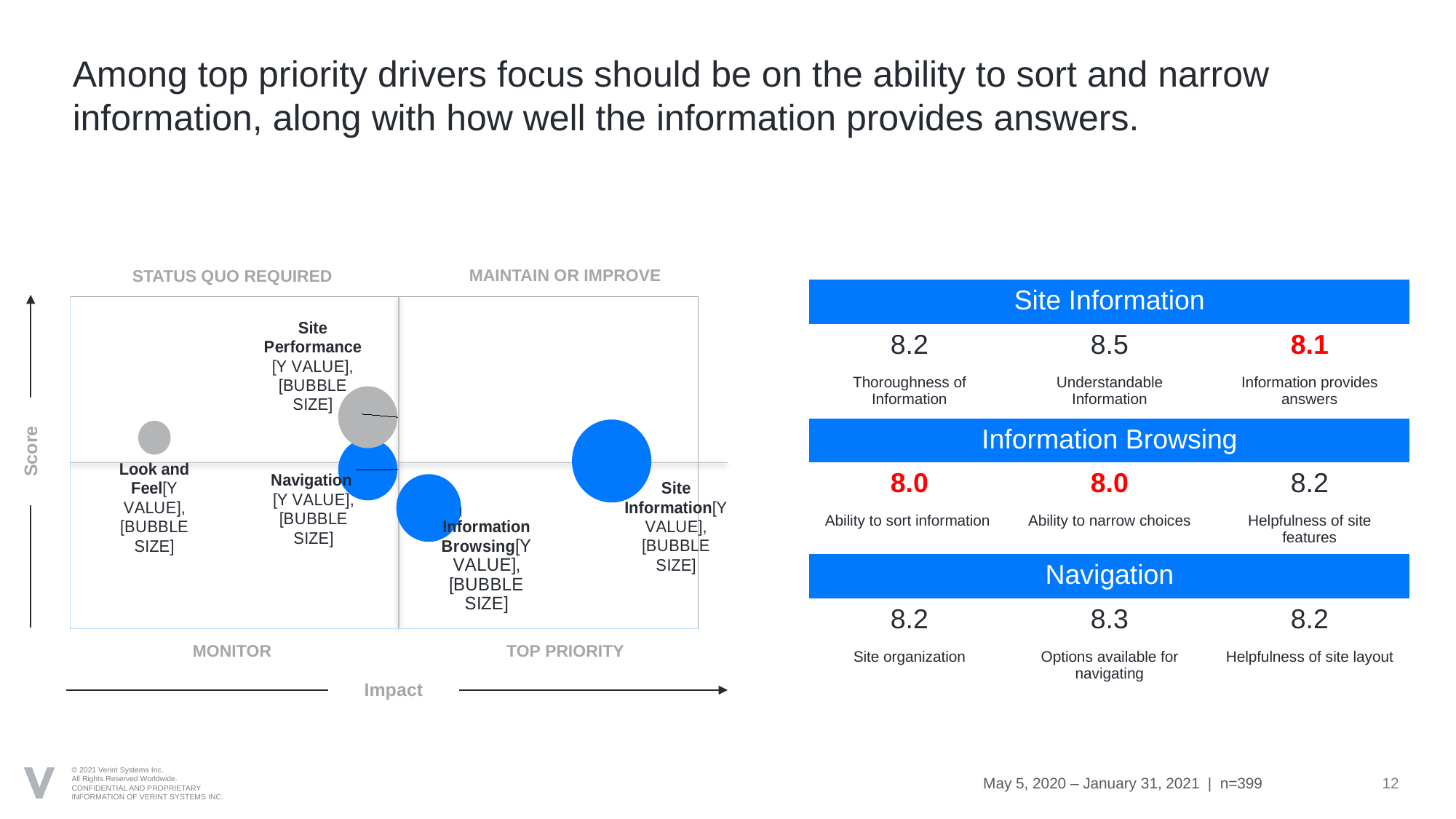
Which bubble in the bubble chart sits highest on the Score axis? Site Performance What is the label of the vertical axis of the bubble chart? Score In the bubble chart, which has the higher Impact: Site Information or Look and Feel? Site Information Which bubble in the bubble chart is positioned furthest to the left (lowest Impact)? Look and Feel Which bubble in the bubble chart is positioned furthest to the right (highest Impact)? Site Information How many bubbles are plotted in the bubble chart? 5 Which bubble in the bubble chart is the smallest? Look and Feel In the bubble chart, which has the higher Score: Site Performance or Information Browsing? Site Performance Which bubble in the bubble chart is the largest? Site Information What kind of chart is shown on the left of the slide? Bubble chart Which bubbles in the bubble chart are coloured grey rather than blue? Look and Feel and Site Performance In which quadrant of the bubble chart does the Site Information bubble fall? Top Priority